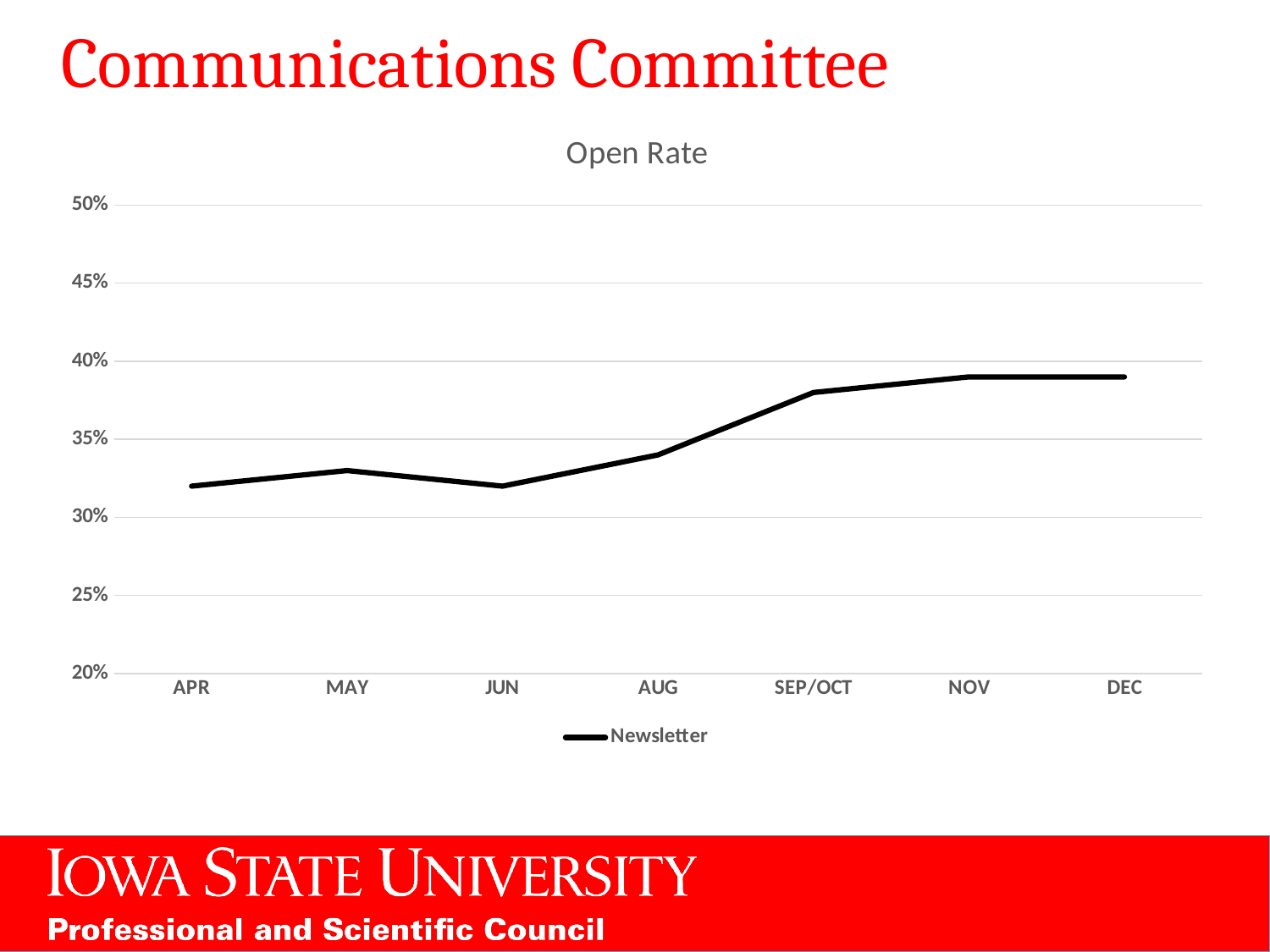
Is the value for NOV greater or less than 40%? less What is the title of the chart? Open Rate How many categories are shown along the x axis? 7 Is the value for JUN greater or less than 35%? less What kind of chart is shown on the slide? line chart Which has the higher open rate, AUG or DEC? DEC Is the value for SEP/OCT greater or less than 35%? greater What is the name of the series shown in the legend? Newsletter How many series does the legend list? 1 Which has the higher open rate, MAY or SEP/OCT? SEP/OCT Overall, does the open rate rise or fall from APR to DEC? rise